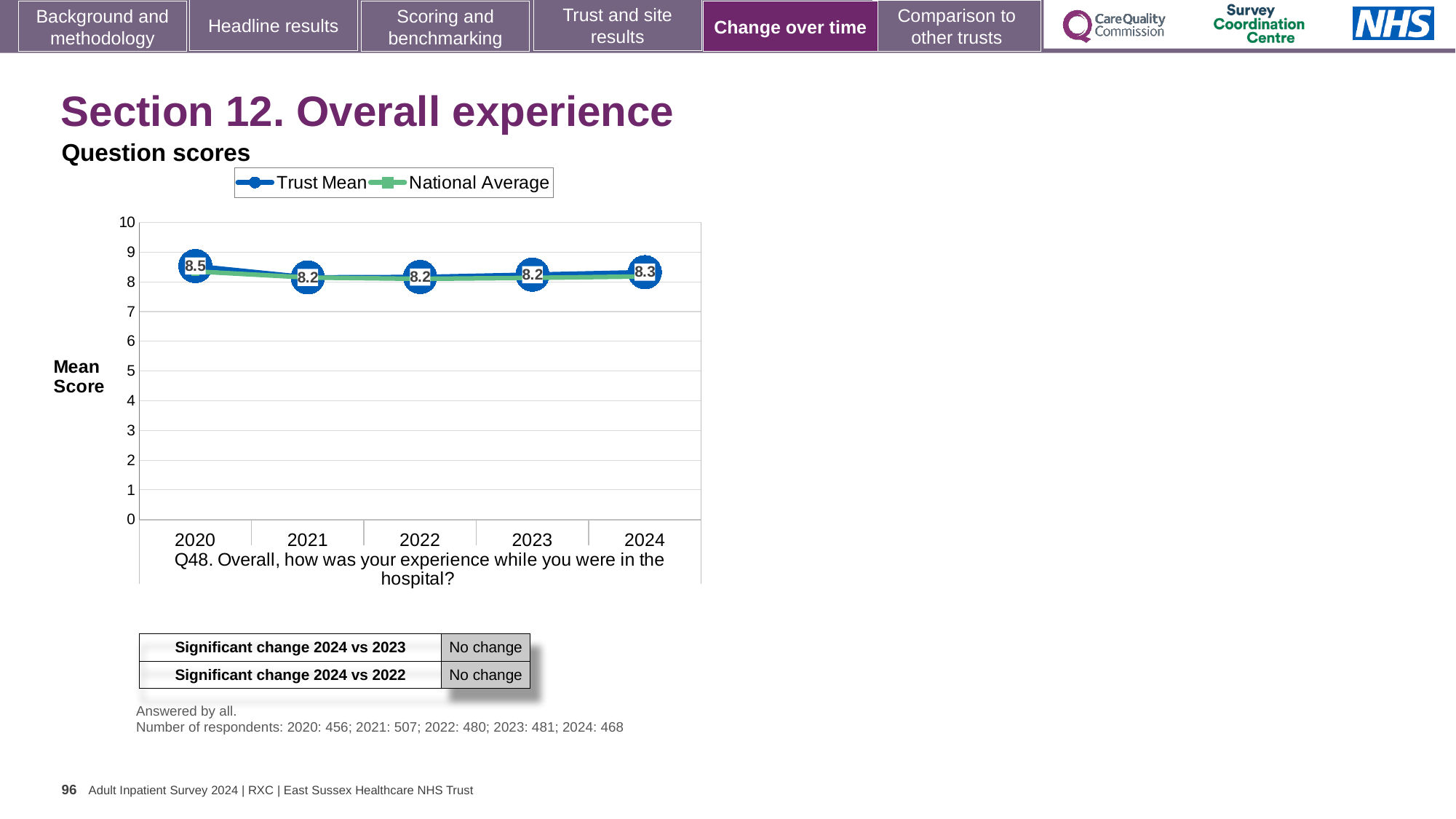
In which year is the Trust Mean highest? 2020 What is the difference between the Trust Mean in 2020 and in 2024? 0.2 What kind of chart is shown on the slide? line chart What is the label on the y axis of the chart? Mean Score How many years are plotted on the x axis? 5 What is the Trust Mean score for 2020? 8.5 Which year has the larger Trust Mean, 2020 or 2021? 2020 Is the National Average value for 2020 greater or less than 8? greater What is the Trust Mean score for 2024? 8.3 Does the Trust Mean rise or fall from 2020 to 2021? fall How many series does the legend list? 2 What is the Trust Mean score for 2022? 8.2